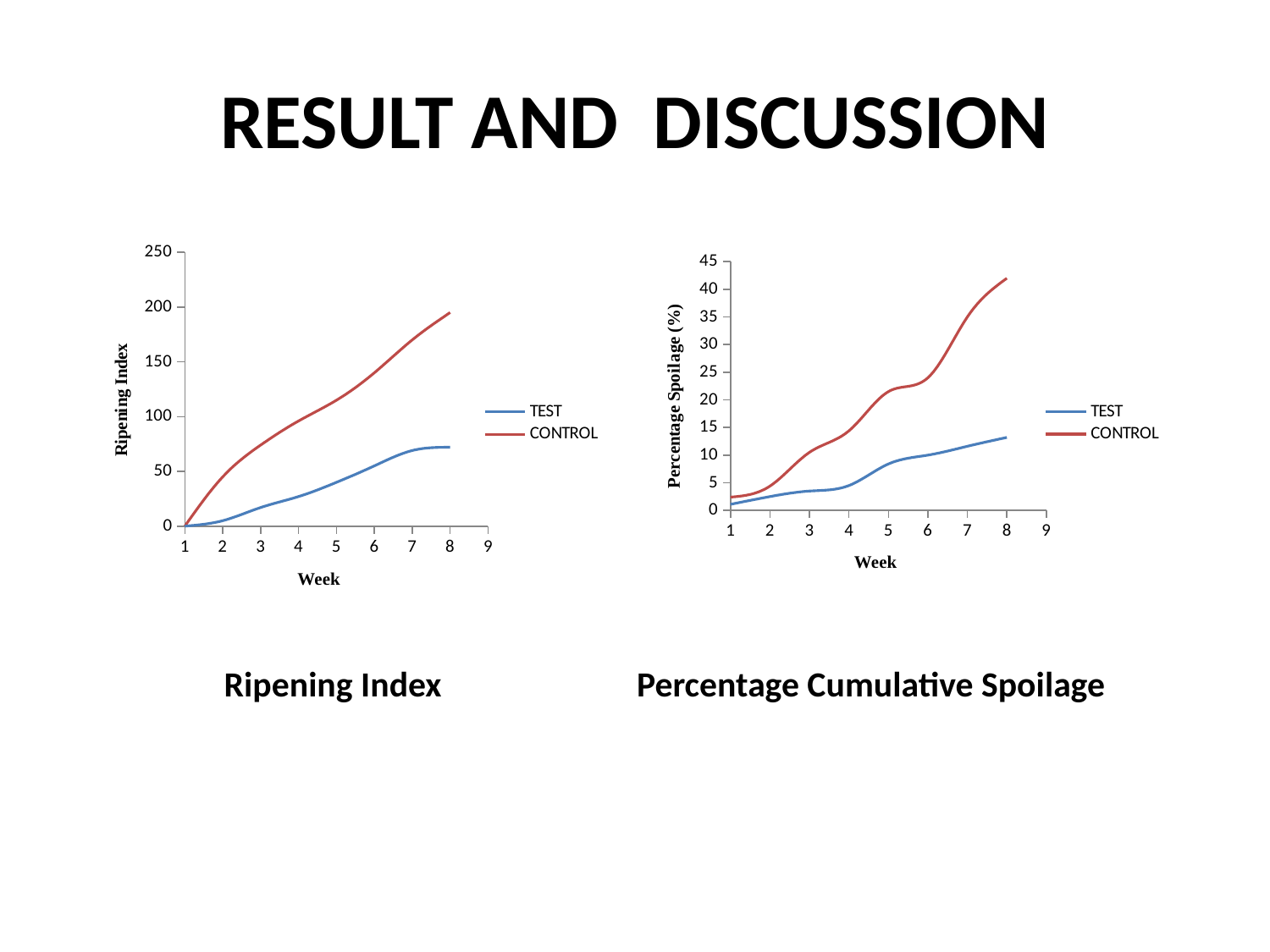
In the Ripening Index chart on the left, is the CONTROL value at week 8 greater or less than 150? greater What kind of chart is the Ripening Index chart on the left? line chart How many series does the legend of the Percentage Cumulative Spoilage chart on the right list? 2 In the Ripening Index chart on the left, is the TEST value at week 4 greater or less than 50? less How many weeks are plotted for each series in the Ripening Index chart on the left? 8 In the Percentage Cumulative Spoilage chart on the right, is the TEST value at week 8 greater or less than 10? greater In the Percentage Cumulative Spoilage chart on the right, does the TEST series rise or fall across the weeks? rise In the Ripening Index chart on the left, which series is higher at week 8, TEST or CONTROL? CONTROL In the Percentage Cumulative Spoilage chart on the right, which series is lower at week 6, TEST or CONTROL? TEST What is the y-axis title of the Percentage Cumulative Spoilage chart on the right? Percentage Spoilage (%) In the Ripening Index chart on the left, does the CONTROL series rise or fall from week 1 to week 8? rise